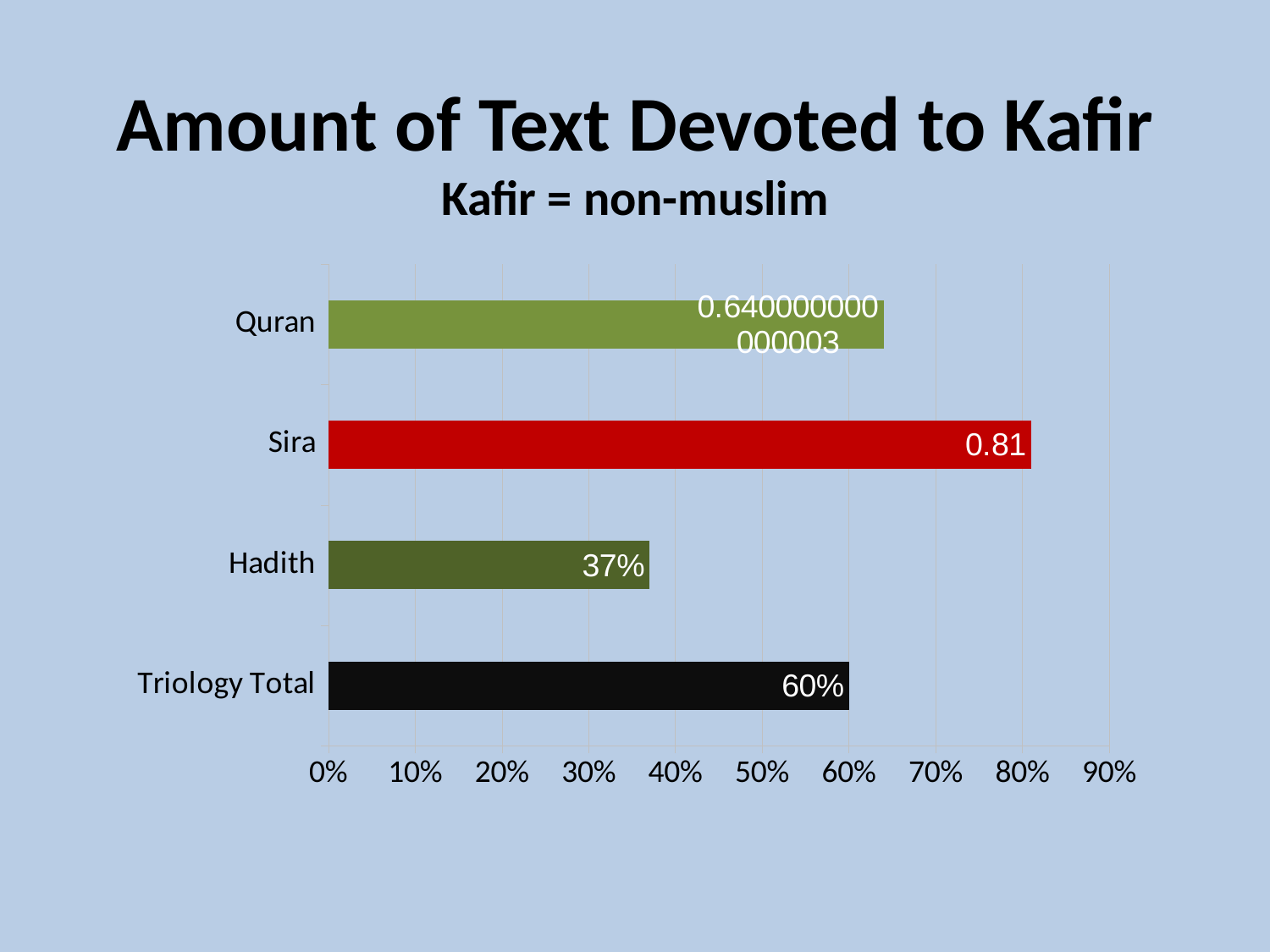
What kind of chart is shown on the slide? bar chart What is the title of the slide? Amount of Text Devoted to Kafir Which is larger, the value for Sira or the value for Quran? Sira What is the value shown for Sira? 0.81 Which category has the lowest value? Hadith What is the value shown for Hadith? 37% Which category has the highest value? Sira What is the value shown for Triology Total? 60% Is the value for Quran greater or less than 60%? greater How many categories are shown in the chart? 4 What is the difference between the Triology Total value and the Hadith value? 23% What data label is printed on the Quran bar? 0.640000000000003